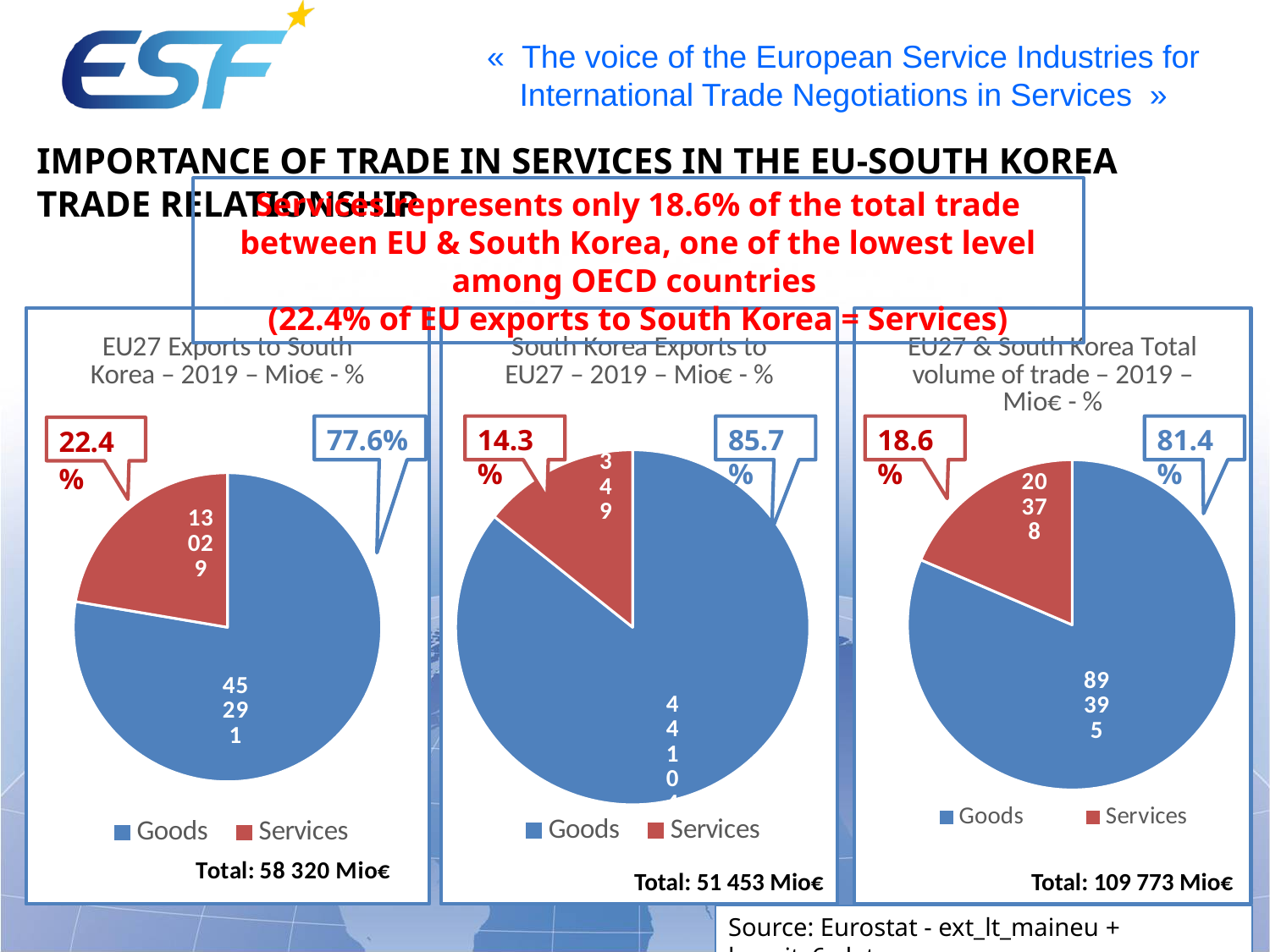
In the 'EU27 & South Korea Total volume of trade – 2019' chart, what colour is the Services slice? Red In the 'EU27 & South Korea Total volume of trade – 2019' chart, what percentage share is shown for Services? 18.6% What total is printed under the 'South Korea Exports to EU27 – 2019' chart? 51 453 Mio€ What type of chart is used in the 'EU27 Exports to South Korea – 2019' chart? Pie chart In the 'EU27 Exports to South Korea – 2019' chart, how many entries does the legend list? 2 What total is printed under the 'EU27 Exports to South Korea – 2019' chart? 58 320 Mio€ In the 'EU27 Exports to South Korea – 2019' chart, what percentage share is shown for Services? 22.4% In the 'South Korea Exports to EU27 – 2019' chart, what percentage share is shown for Goods? 85.7% What total is printed under the 'EU27 & South Korea Total volume of trade – 2019' chart? 109 773 Mio€ In the 'South Korea Exports to EU27 – 2019' chart, what percentage share is shown for Services? 14.3% In the 'EU27 Exports to South Korea – 2019' chart, which slice is larger, Goods or Services? Goods In the 'EU27 & South Korea Total volume of trade – 2019' chart, which category has the largest slice? Goods